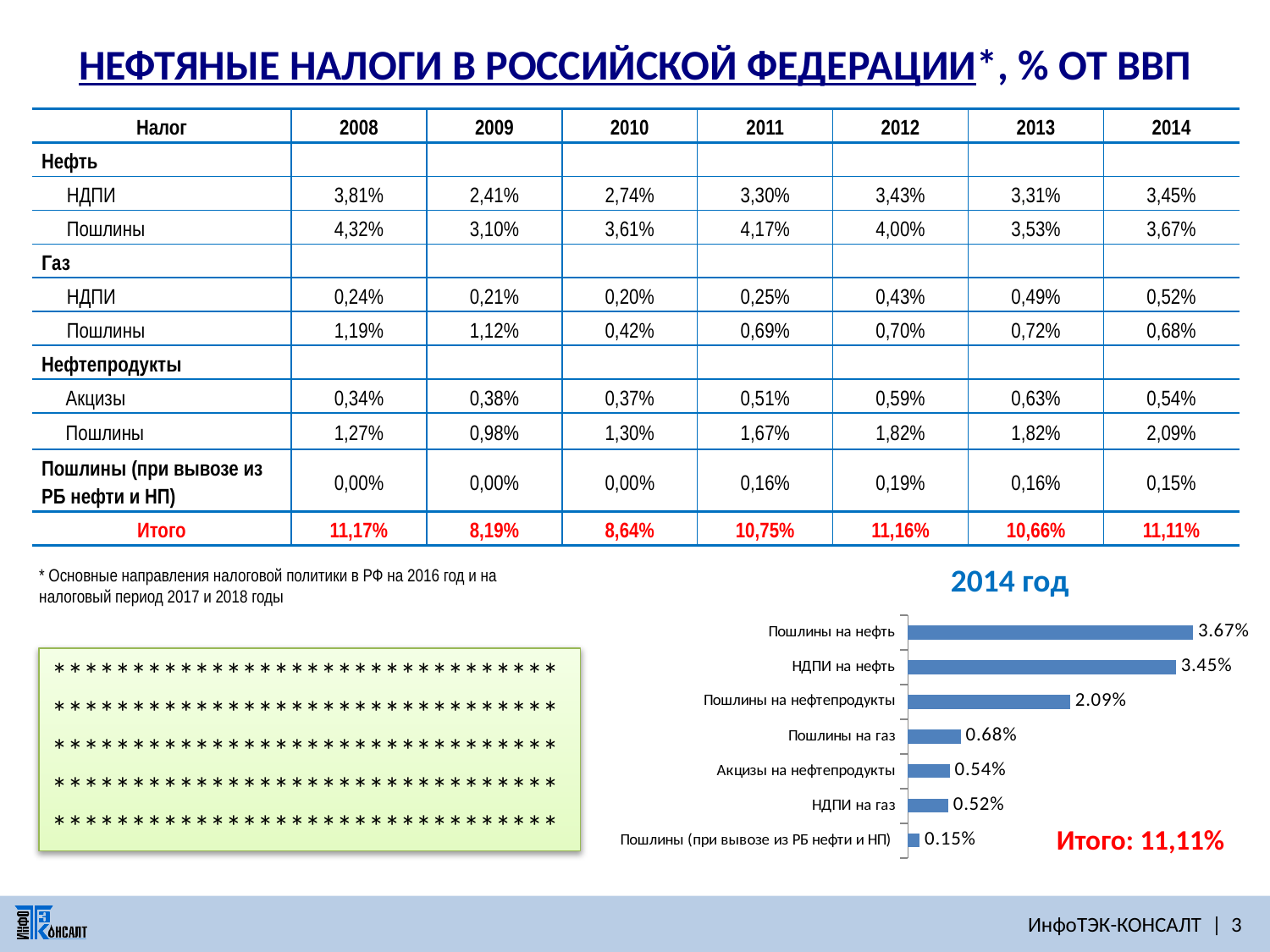
What total (Итого) is printed next to the "2014 год" chart? 11,11% In the "2014 год" chart, what is the difference between Пошлины на нефть and НДПИ на нефть? 0.22% What type of chart is shown under the heading "2014 год"? bar chart In the "2014 год" chart, which category has the lowest value? Пошлины (при вывозе из РБ нефти и НП) In the "2014 год" chart, which category has the highest value? Пошлины на нефть In the "2014 год" chart, which is larger: Пошлины на газ or НДПИ на газ? Пошлины на газ In the "2014 год" chart, what is the value for Пошлины на нефть? 3.67% How many categories are plotted in the "2014 год" chart? 7 In the "2014 год" chart, what is the value for НДПИ на нефть? 3.45% In the "2014 год" chart, what is the value for Пошлины (при вывозе из РБ нефти и НП)? 0.15% In the "2014 год" chart, what is the value for Акцизы на нефтепродукты? 0.54% In the "2014 год" chart, what is the value for Пошлины на нефтепродукты? 2.09%